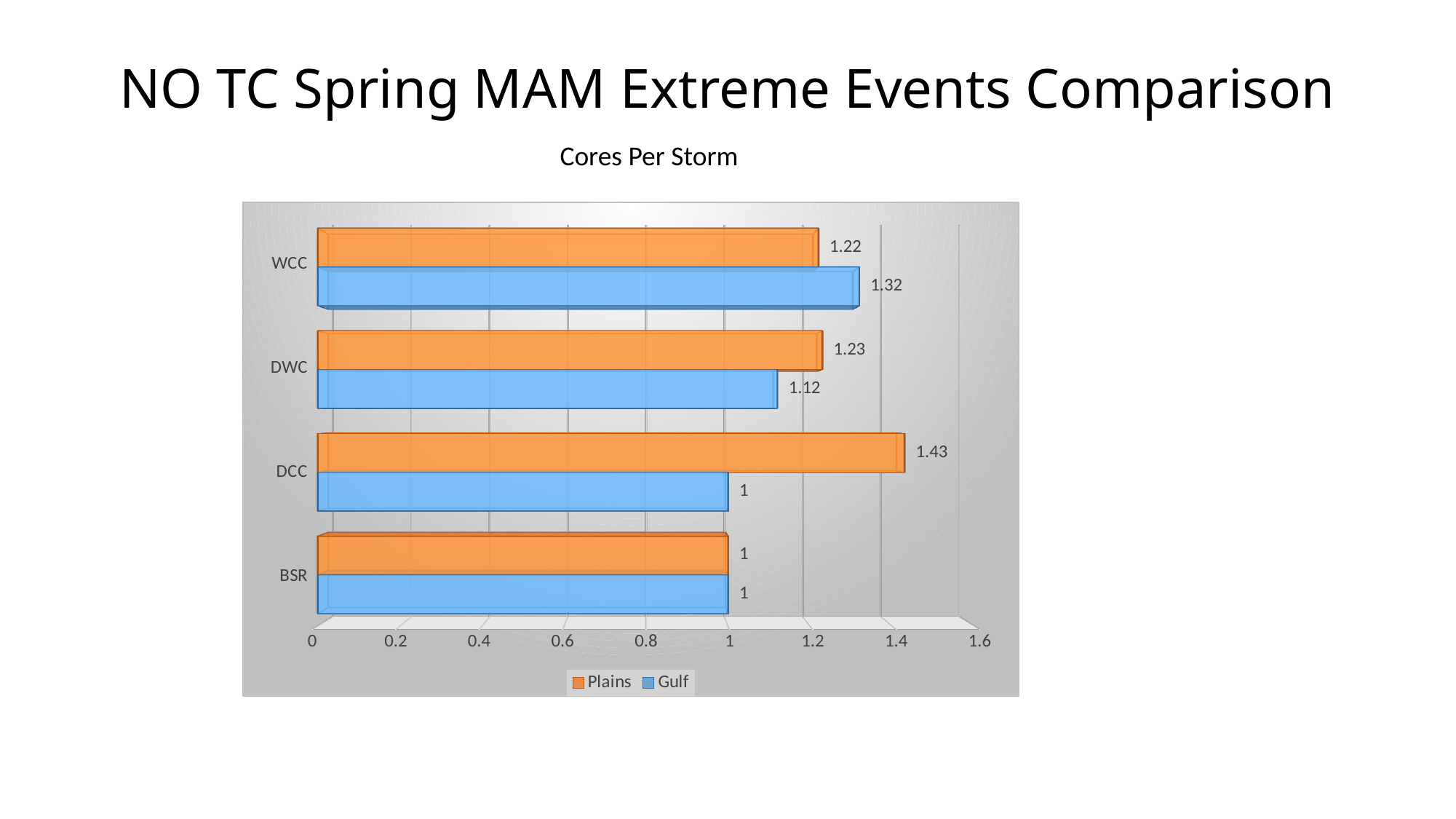
For WCC, which series has the larger value, Plains or Gulf? Gulf What is the Plains value for WCC? 1.22 What type of chart is shown? Bar chart How many series does the legend list? 2 What is the Gulf value for WCC? 1.32 What is the Plains value for DCC? 1.43 Which category has the highest Gulf value? WCC What is the Gulf value for DWC? 1.12 How many categories are shown on the chart? 4 Which category has the highest Plains value? DCC For DWC, which series has the larger value, Plains or Gulf? Plains What is the difference between the Plains and Gulf values for DCC? 0.43